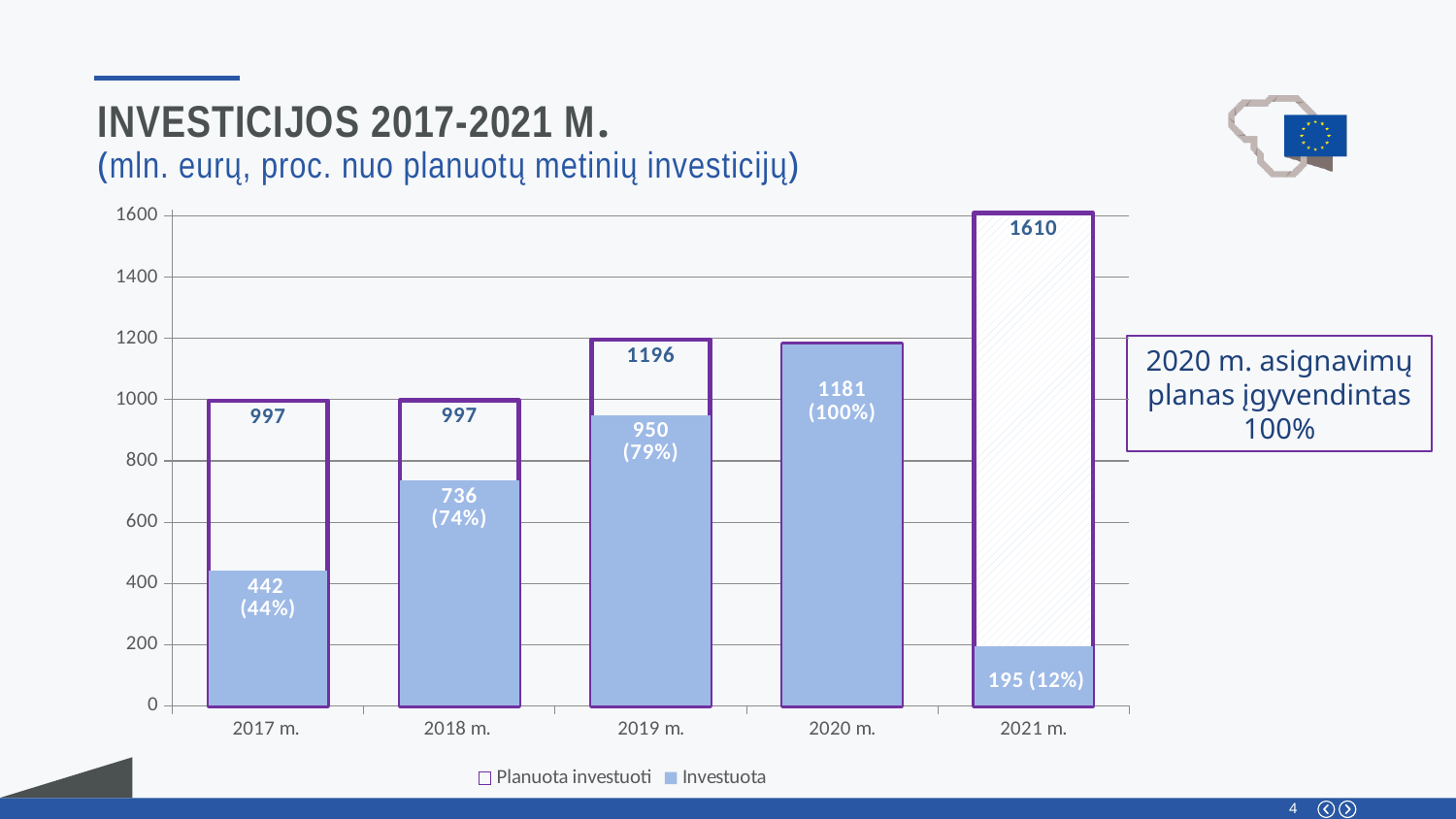
How many series does the legend list? 2 Which year has the lowest 'Investuota' value? 2021 m. What is the 'Planuota investuoti' value for 2019 m.? 1196 Which year has the highest 'Planuota investuoti' value? 2021 m. Is the 'Investuota' value for 2018 m. larger than the 'Investuota' value for 2017 m.? Yes What type of chart is shown on the slide? bar chart What is the 'Investuota' value for 2017 m.? 442 (44%) What is the 'Planuota investuoti' value for 2021 m.? 1610 What does the text box to the right of the chart say? 2020 m. asignavimų planas įgyvendintas 100% What is the difference between the 'Planuota investuoti' and 'Investuota' values for 2018 m.? 261 How many years are shown on the x axis? 5 What is the 'Investuota' value for 2019 m.? 950 (79%)